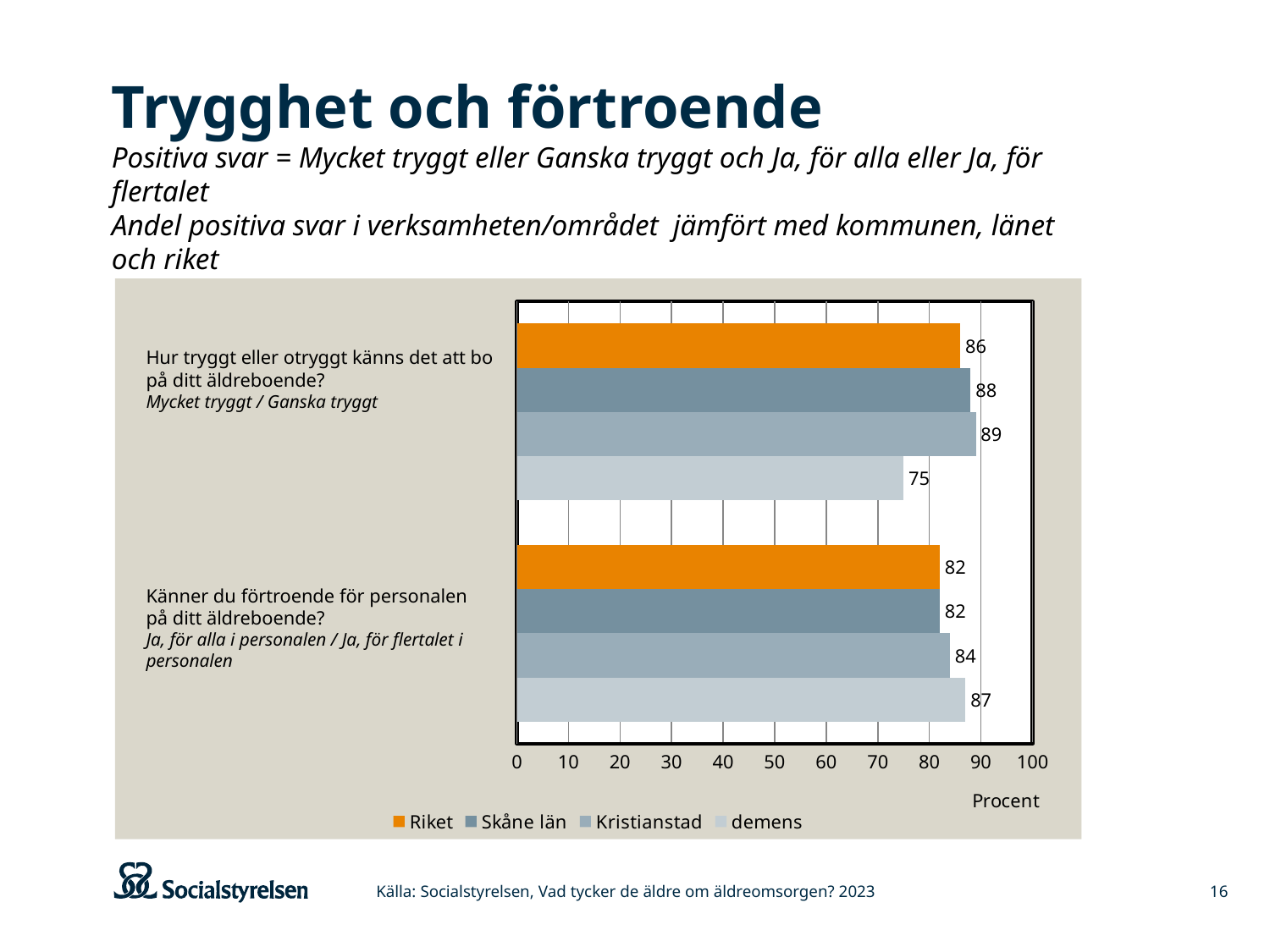
Which series has the highest value for the question "Hur tryggt eller otryggt känns det att bo på ditt äldreboende?"? Kristianstad Is the demens value for the question "Hur tryggt eller otryggt känns det att bo på ditt äldreboende?" greater or less than 80? less How many survey questions (categories) are shown on the chart? 2 Which series has the lowest value for the question "Känner du förtroende för personalen på ditt äldreboende?"? Riket and Skåne län (both 82) What value does Kristianstad have for the question "Känner du förtroende för personalen på ditt äldreboende?"? 84 What value does the demens series have for the question "Hur tryggt eller otryggt känns det att bo på ditt äldreboende?"? 75 How many series does the legend list? 4 What is the difference between the Kristianstad value and the demens value for the question "Hur tryggt eller otryggt känns det att bo på ditt äldreboende?"? 14 What value does Riket have for the question "Hur tryggt eller otryggt känns det att bo på ditt äldreboende?"? 86 For the question "Känner du förtroende för personalen på ditt äldreboende?", which is larger: the demens value or the Riket value? demens What kind of chart is shown on the slide? Bar chart What is the label of the horizontal axis? Procent